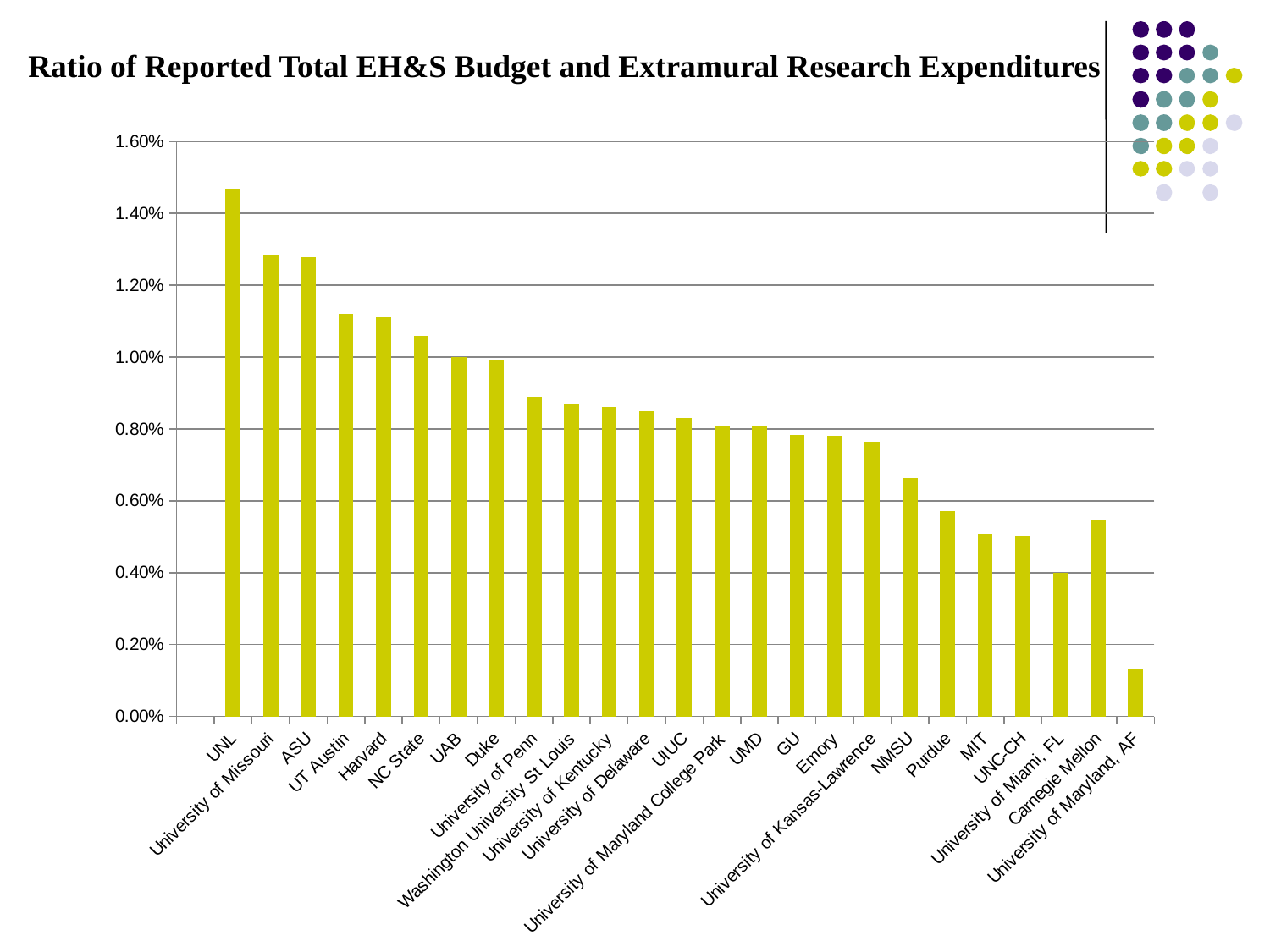
What is the title of the chart? Ratio of Reported Total EH&S Budget and Extramural Research Expenditures What kind of chart is shown on the slide? Bar chart Which has a larger ratio, Harvard or MIT? Harvard Do the values generally rise or fall moving from left to right along the x axis? fall Which university has the highest ratio in the chart? UNL Which university has the lowest ratio in the chart? University of Maryland, AF Is the value for UNL greater or less than 1.40%? greater Is the value for University of Maryland, AF greater or less than 0.20%? less Is the value for NMSU greater or less than 0.60%? greater How many universities are plotted in the chart? 25 Which has a larger ratio, Carnegie Mellon or University of Miami, FL? Carnegie Mellon